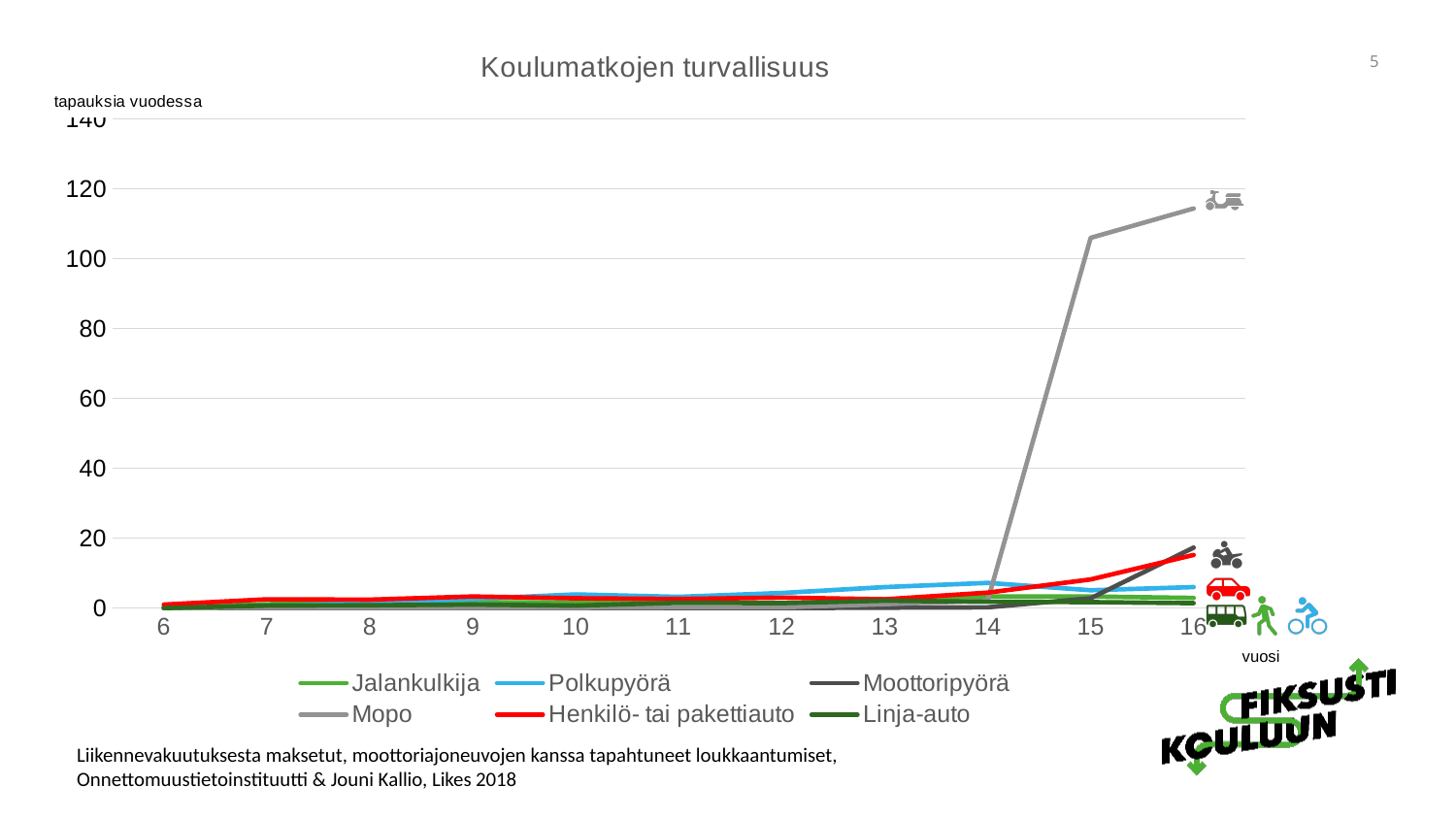
Is the value for Mopo at year 16 greater or less than 100? greater What is the title of the chart? Koulumatkojen turvallisuus Does the Mopo series rise or fall between year 14 and year 16? rise At year 16, which is larger: Mopo or Polkupyörä? Mopo What kind of chart is shown on the slide? line chart How many series does the legend list? 6 Which series has the highest value at year 16? Mopo What label is shown on the y axis of the chart? tapauksia vuodessa How many years are shown along the x axis? 11 Is the value for Mopo at year 15 greater or less than 100? greater Is the value for Mopo at year 14 greater or less than 20? less